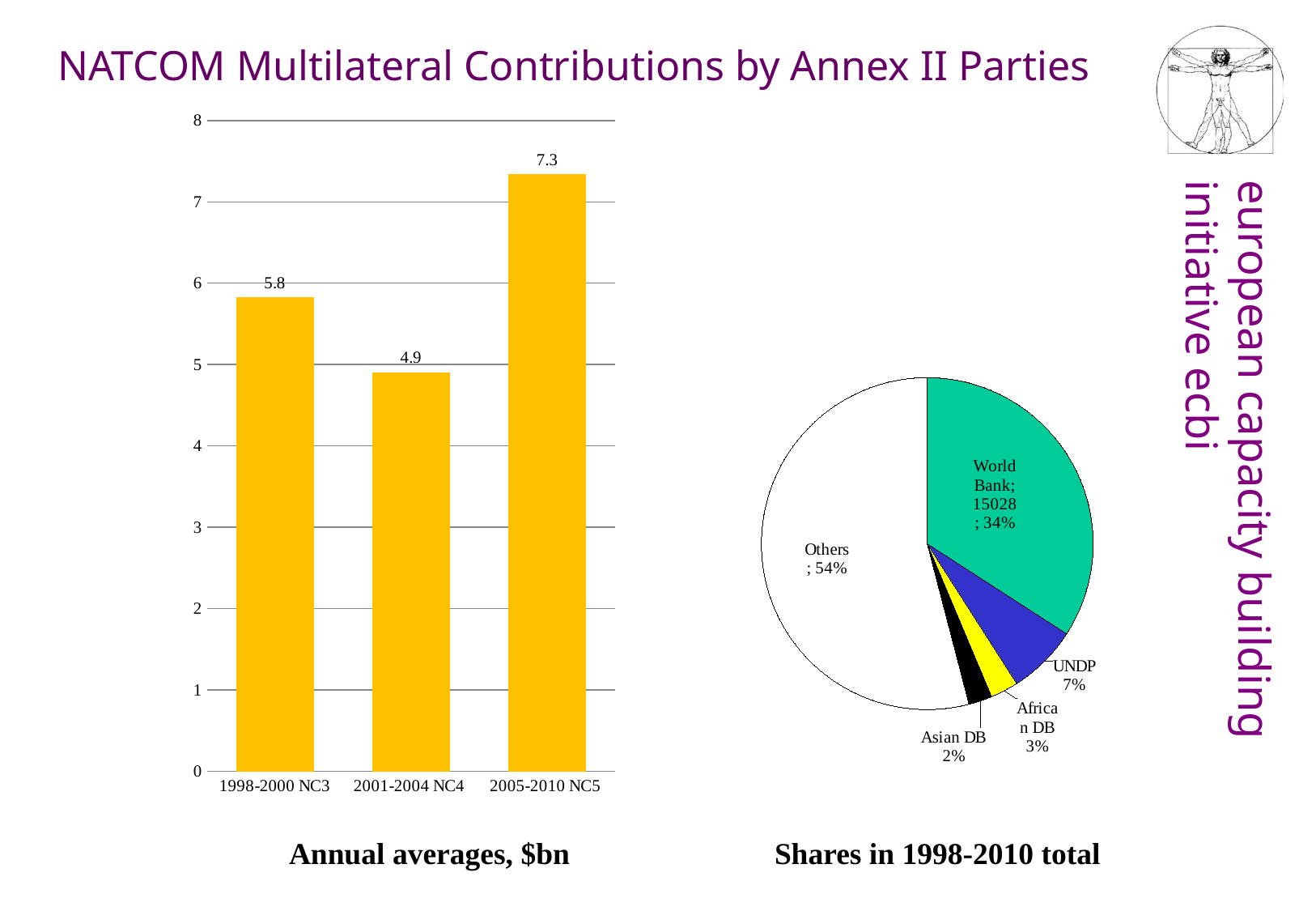
In the pie chart on the right (Shares in 1998-2010 total), which slice is the largest? Others How many slices are in the pie chart on the right (Shares in 1998-2010 total)? 5 What kind of chart is the chart on the left of the slide? bar chart In the bar chart on the left (Annual averages, $bn), which period has the highest value? 2005-2010 NC5 In the bar chart on the left (Annual averages, $bn), what is the value for 1998-2000 NC3? 5.8 In the pie chart on the right (Shares in 1998-2010 total), what share does World Bank have? 34% How many bars are in the bar chart on the left (Annual averages, $bn)? 3 In the bar chart on the left (Annual averages, $bn), which period has the lowest value? 2001-2004 NC4 In the pie chart on the right (Shares in 1998-2010 total), what share does UNDP have? 7% In the bar chart on the left (Annual averages, $bn), what is the value for 2005-2010 NC5? 7.3 In the bar chart on the left (Annual averages, $bn), is the value for 1998-2000 NC3 larger or smaller than the value for 2001-2004 NC4? larger In the bar chart on the left (Annual averages, $bn), what is the difference between the values for 2005-2010 NC5 and 2001-2004 NC4? 2.4